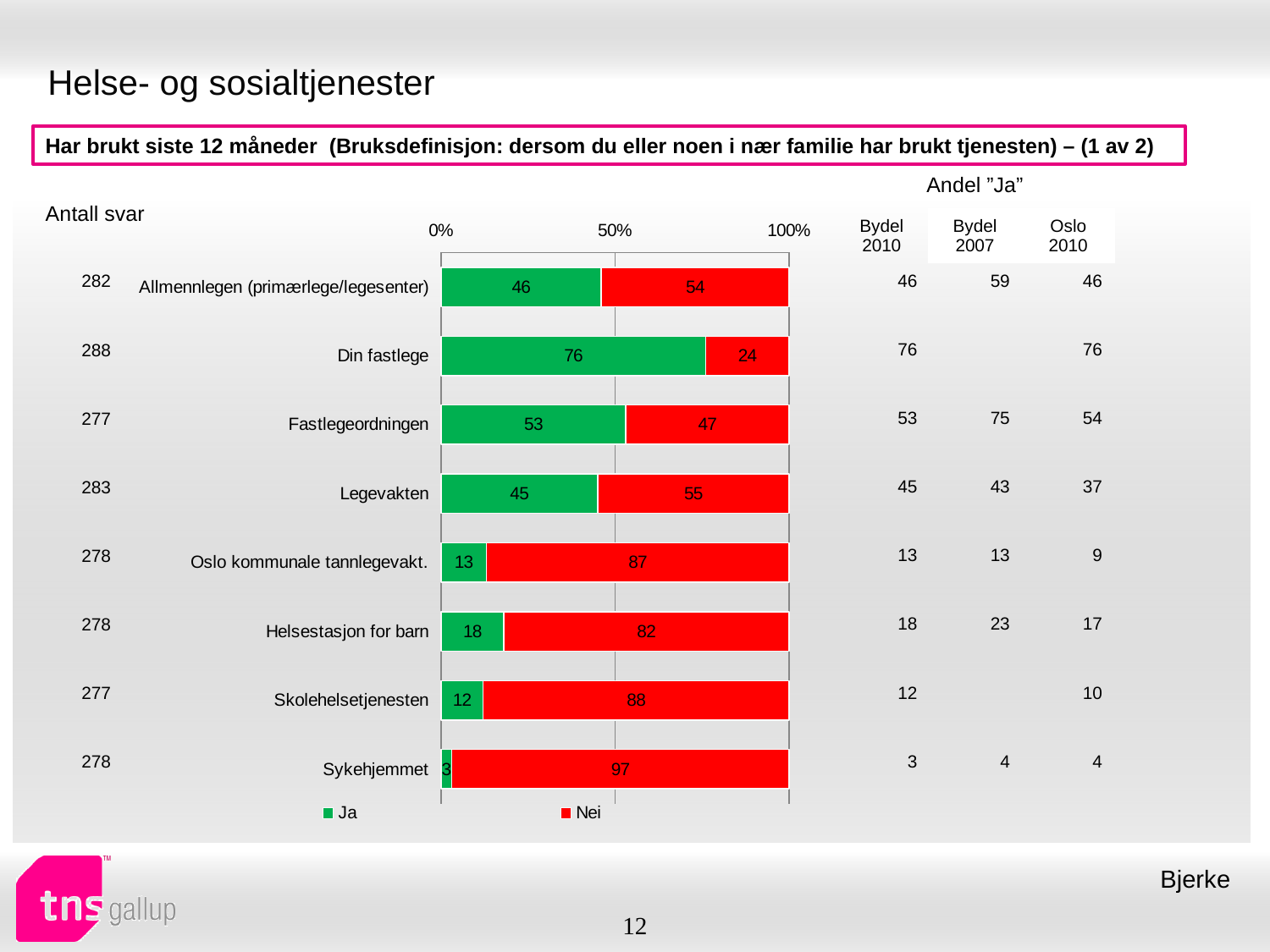
What is the "Ja" value for Helsestasjon for barn? 18 Which has a larger "Nei" value, Legevakten or Fastlegeordningen? Legevakten How many series does the legend list? 2 How many categories are shown in the chart? 8 What is the "Ja" value for Din fastlege? 76 Which colour represents "Nei" in the chart? Red What is the difference between the "Ja" values for Din fastlege and Allmennlegen (primærlege/legesenter)? 30 What kind of chart is shown on the slide? Stacked bar chart What is the total of the stacked bar for Skolehelsetjenesten? 100 Which category has the highest "Ja" value? Din fastlege What is the "Nei" value for Oslo kommunale tannlegevakt.? 87 Which category has the lowest "Ja" value? Sykehjemmet